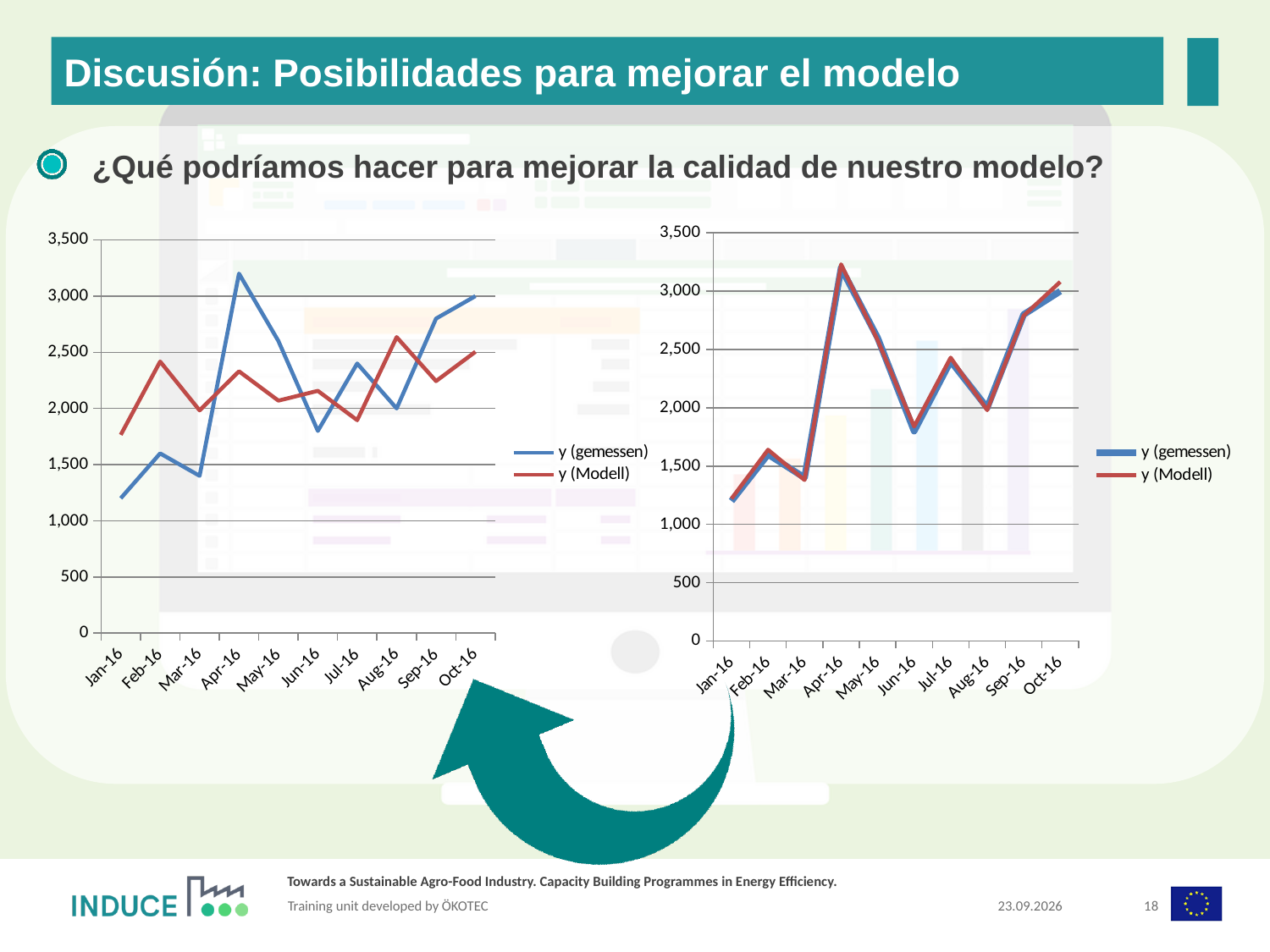
In the left chart, which month has the lowest value for y (gemessen)? Jan-16 In the left chart, is the value of y (gemessen) for Apr-16 greater or less than 3,000? greater In the left chart, which series has the larger value in Apr-16, y (gemessen) or y (Modell)? y (gemessen) How many months are shown on the x axis of the left chart? 10 In the right chart, which month has the highest value for y (gemessen)? Apr-16 What kind of chart is the left chart? line chart In the left chart, which month has the highest value for y (gemessen)? Apr-16 In the left chart, is the value of y (gemessen) for Jan-16 greater or less than 1,500? less In the left chart, which series has the larger value in Jun-16, y (gemessen) or y (Modell)? y (Modell) What are the two legend entries of the left chart? y (gemessen) and y (Modell) In the right chart, is the value of y (Modell) for Jan-16 greater or less than 1,500? less How many series does the legend of the right chart list? 2